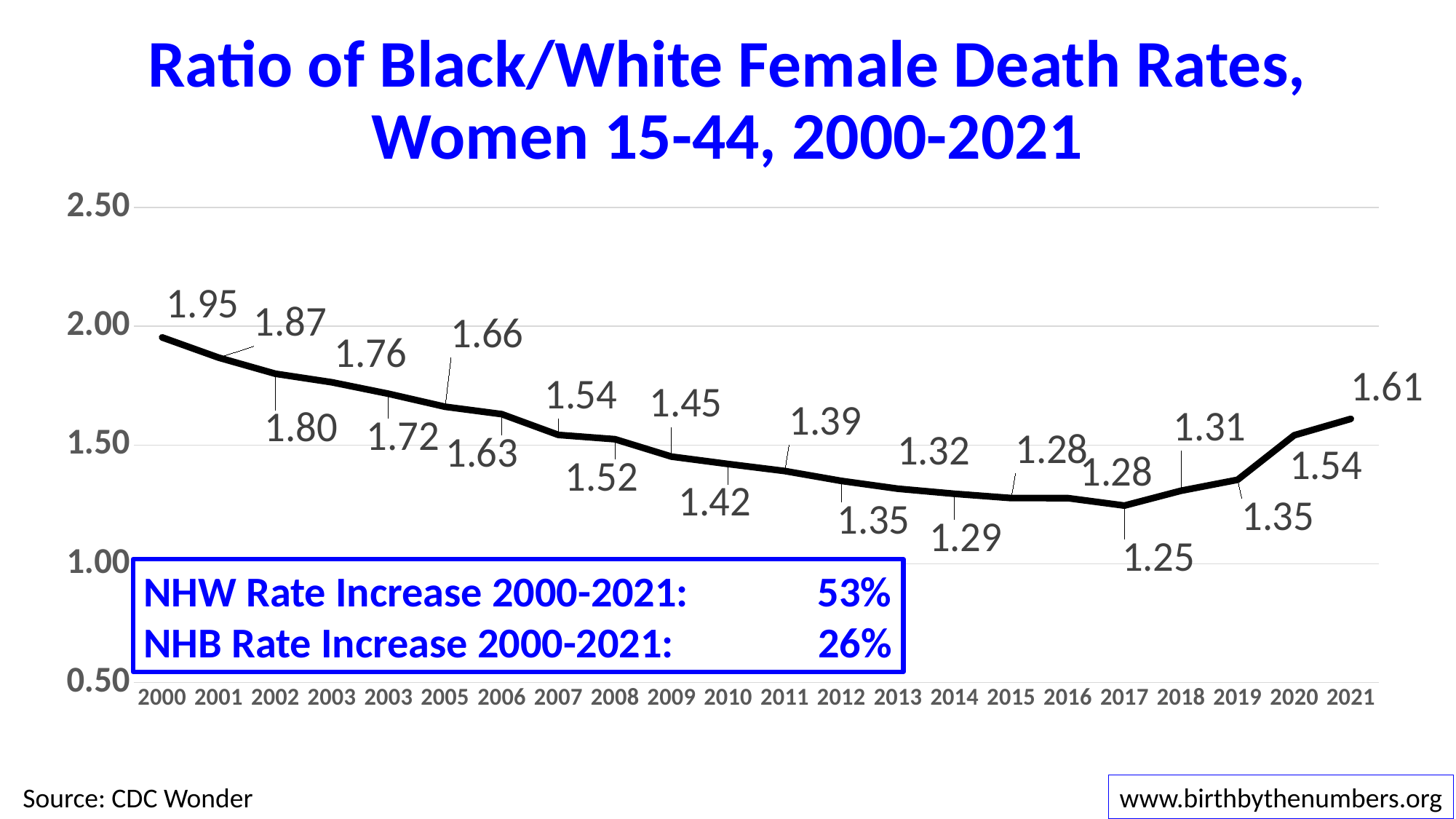
According to the text box on the chart, what was the NHW rate increase from 2000 to 2021? 53% What is the ratio of Black/White female death rates in 2021? 1.61 Which year has the larger ratio, 2019 or 2020? 2020 What is the ratio value plotted for 2010? 1.42 What kind of chart is shown on the slide? Line chart How many data points are plotted on the line? 22 By how much did the ratio fall from 2000 to 2021? 0.34 In which year is the ratio of Black/White female death rates lowest? 2017 What is the ratio of Black/White female death rates in 2000? 1.95 What is the ratio value plotted for 2017? 1.25 Does the ratio rise or fall from 2000 to 2017? Fall In which year is the ratio of Black/White female death rates highest? 2000